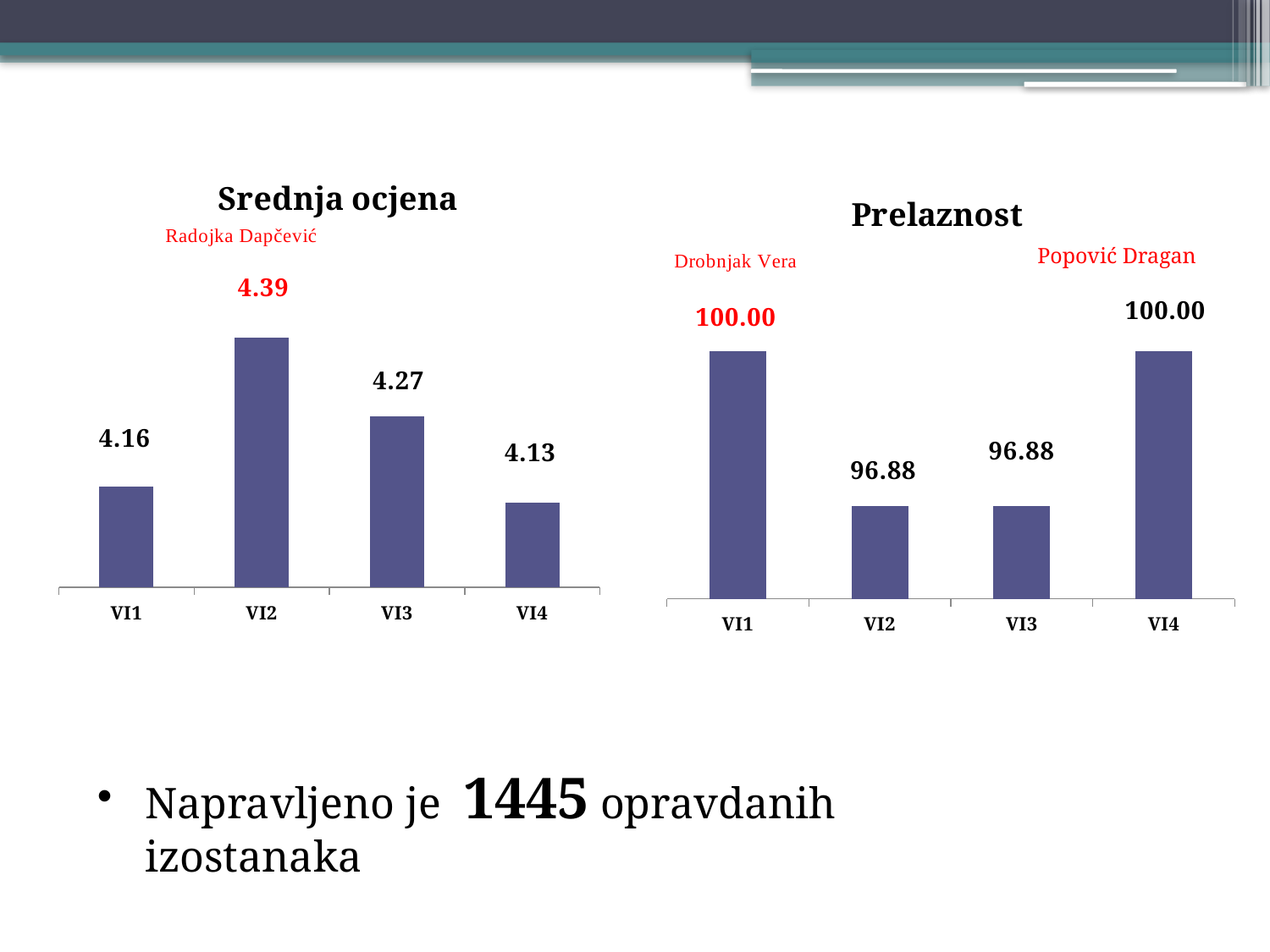
In the 'Srednja ocjena' chart, which name is printed in red above the VI2 bar? Radojka Dapčević In the 'Prelaznost' chart, what is the value for VI4? 100.00 In the 'Srednja ocjena' chart, what is the value for VI2? 4.39 In the 'Prelaznost' chart, what is the difference between the values for VI1 and VI3? 3.12 In the 'Srednja ocjena' chart, what is the value for VI4? 4.13 In the 'Prelaznost' chart, what is the value for VI2? 96.88 How many categories are shown in the 'Prelaznost' chart? 4 In the 'Srednja ocjena' chart, which category has the highest value? VI2 In the 'Srednja ocjena' chart, which category has the lowest value? VI4 In the 'Srednja ocjena' chart, which is larger, the value for VI1 or VI3? VI3 In the 'Srednja ocjena' chart, what is the difference between the values for VI2 and VI1? 0.23 What kind of chart is the 'Srednja ocjena' chart? Bar chart